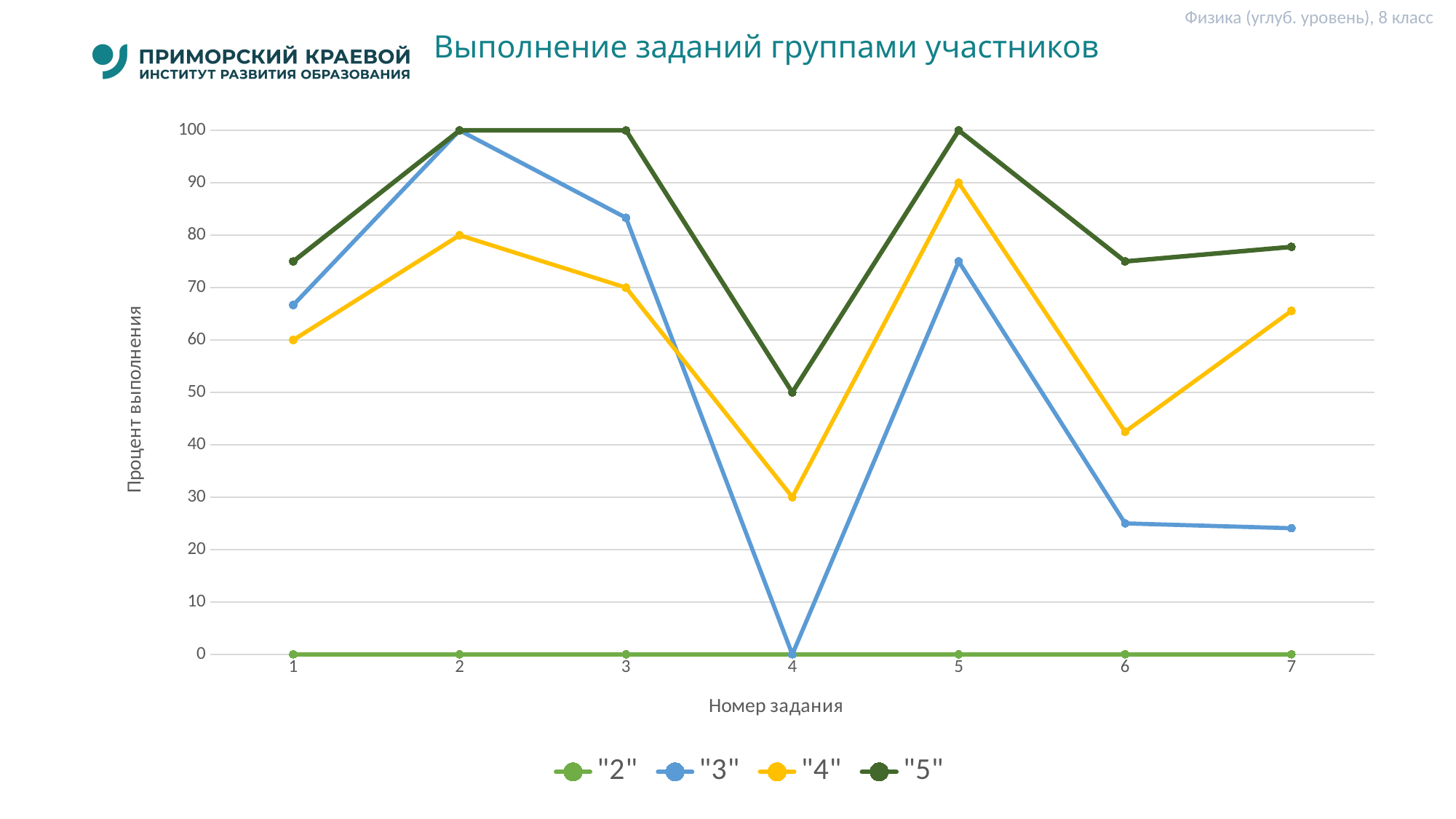
Which series has the highest value at task 6? "5" How many task numbers are plotted along the x axis? 7 Which is larger at task 7: the value for series "4" or the value for series "3"? "4" What kind of chart is shown on the slide? line chart How many series does the legend list? 4 What is the value for series "3" at task 4? 0 What is the difference between the values of series "5" and series "4" at task 4? 20 What is the value for series "4" at task 2? 80 What is the value for series "5" at task 4? 50 Is the value for series "3" at task 6 greater or less than 30? less What is the value for series "4" at task 5? 90 Which series has the lowest value at task 3? "2"